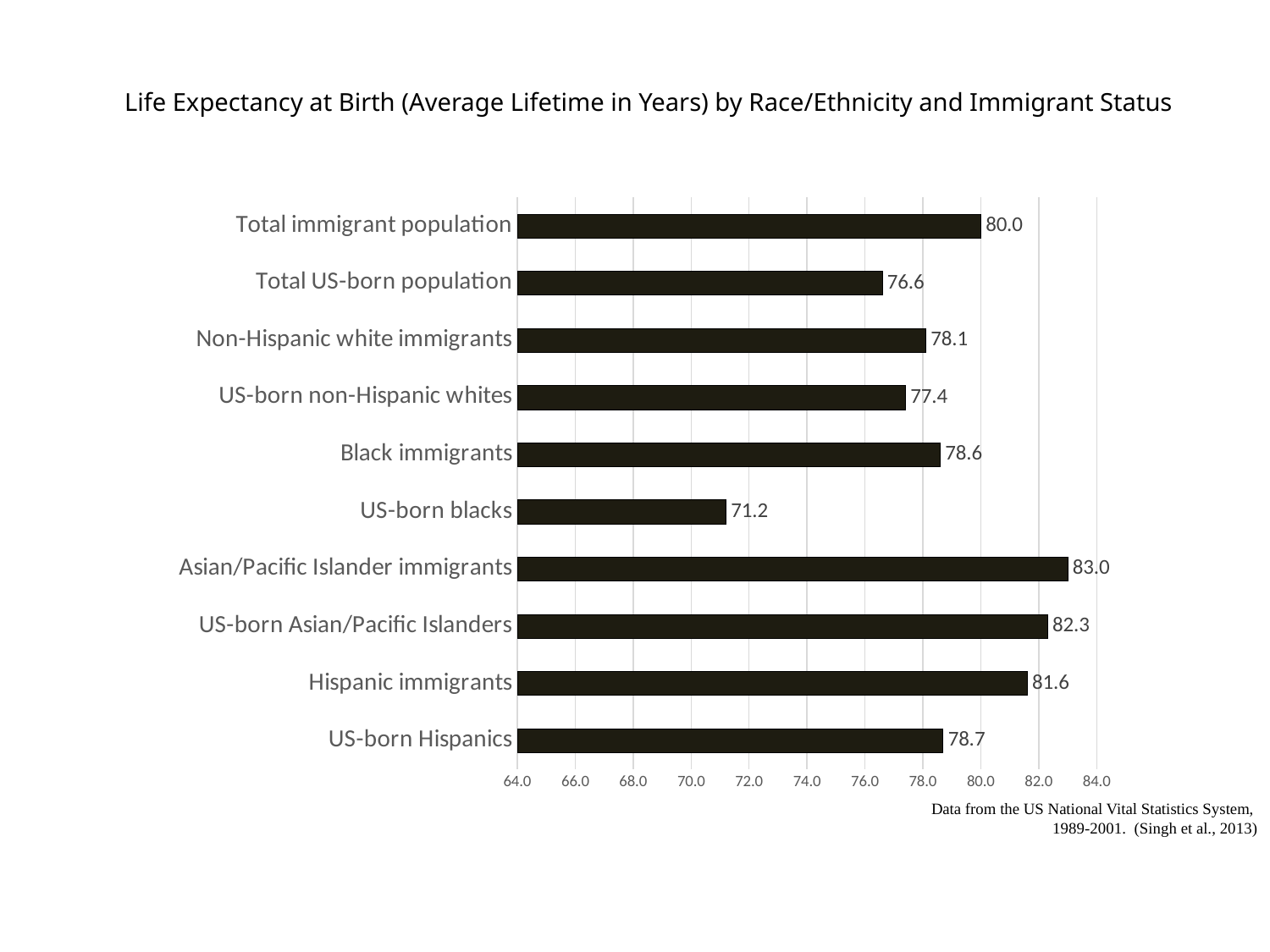
Which category has the lowest life expectancy at birth? US-born blacks How many categories are shown in the chart? 10 What is the life expectancy at birth for Hispanic immigrants? 81.6 What kind of chart is shown on the slide? Bar chart What is the title of the chart? Life Expectancy at Birth (Average Lifetime in Years) by Race/Ethnicity and Immigrant Status Which category has the highest life expectancy at birth? Asian/Pacific Islander immigrants What is the difference in life expectancy between Black immigrants and US-born blacks? 7.4 What is the life expectancy at birth for US-born blacks? 71.2 Which has a higher life expectancy, Non-Hispanic white immigrants or US-born non-Hispanic whites? Non-Hispanic white immigrants What is the difference in life expectancy between the total immigrant population and the total US-born population? 3.4 Is the life expectancy for US-born Hispanics greater or less than 76.0? greater What is the life expectancy at birth for the total immigrant population? 80.0